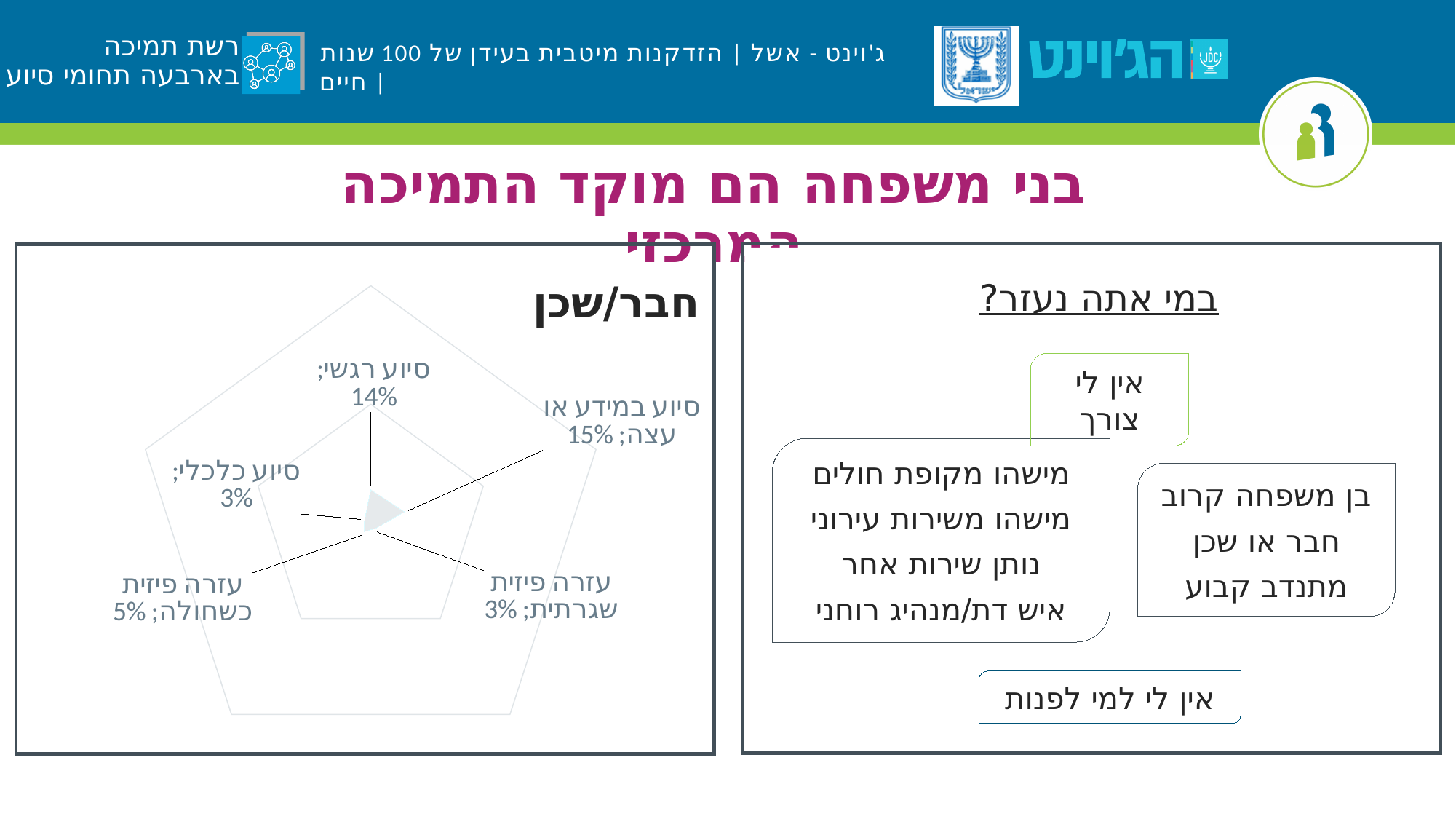
What is the value for עזרה פיזית שגרתית? 3% What is the title of the chart on the slide? חבר/שכן What kind of chart is shown on the slide? Radar chart Which category has the highest value? סיוע במידע או עצה What is the value for סיוע כלכלי? 3% What is the value for סיוע במידע או עצה? 15% Which is larger, עזרה פיזית כשחולה or סיוע כלכלי? עזרה פיזית כשחולה What is the difference between סיוע רגשי and עזרה פיזית שגרתית? 11% How many categories does the radar chart have? 5 What is the difference between סיוע במידע או עצה and סיוע רגשי? 1% What is the value for סיוע רגשי? 14% What is the value for עזרה פיזית כשחולה? 5%